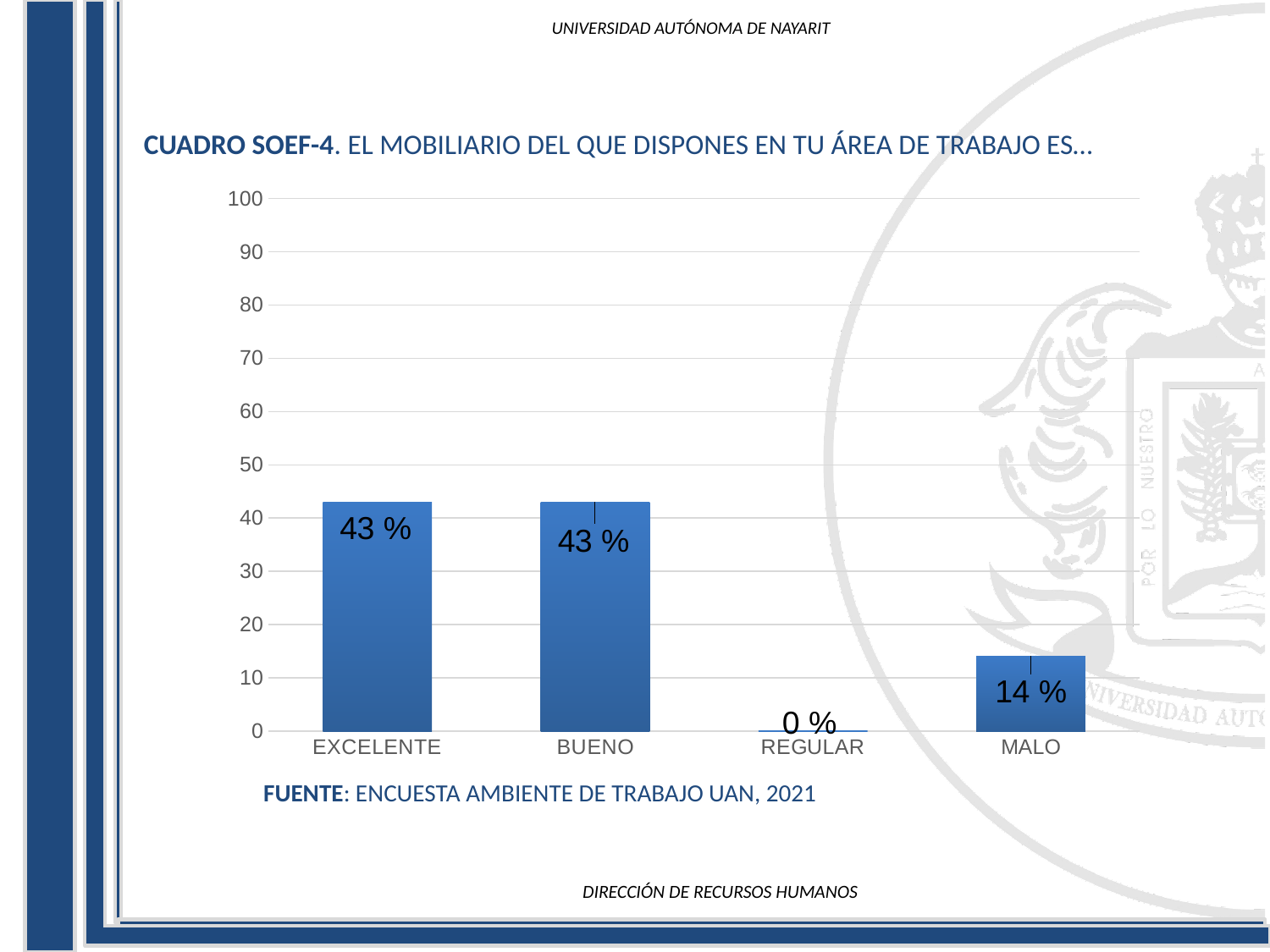
What is the value for MALO? 14 % How many categories are shown on the x axis? 4 What is the highest value shown on the y axis? 100 Which is larger, the value for MALO or the value for REGULAR? MALO What is the value for EXCELENTE? 43 % What kind of chart is shown on the slide? bar chart What is the value for BUENO? 43 % What is the source cited below the chart? ENCUESTA AMBIENTE DE TRABAJO UAN, 2021 Is the value for BUENO greater or less than 50? less What is the value for REGULAR? 0 % What is the difference between the values for EXCELENTE and MALO? 29 % Which category has the lowest value? REGULAR